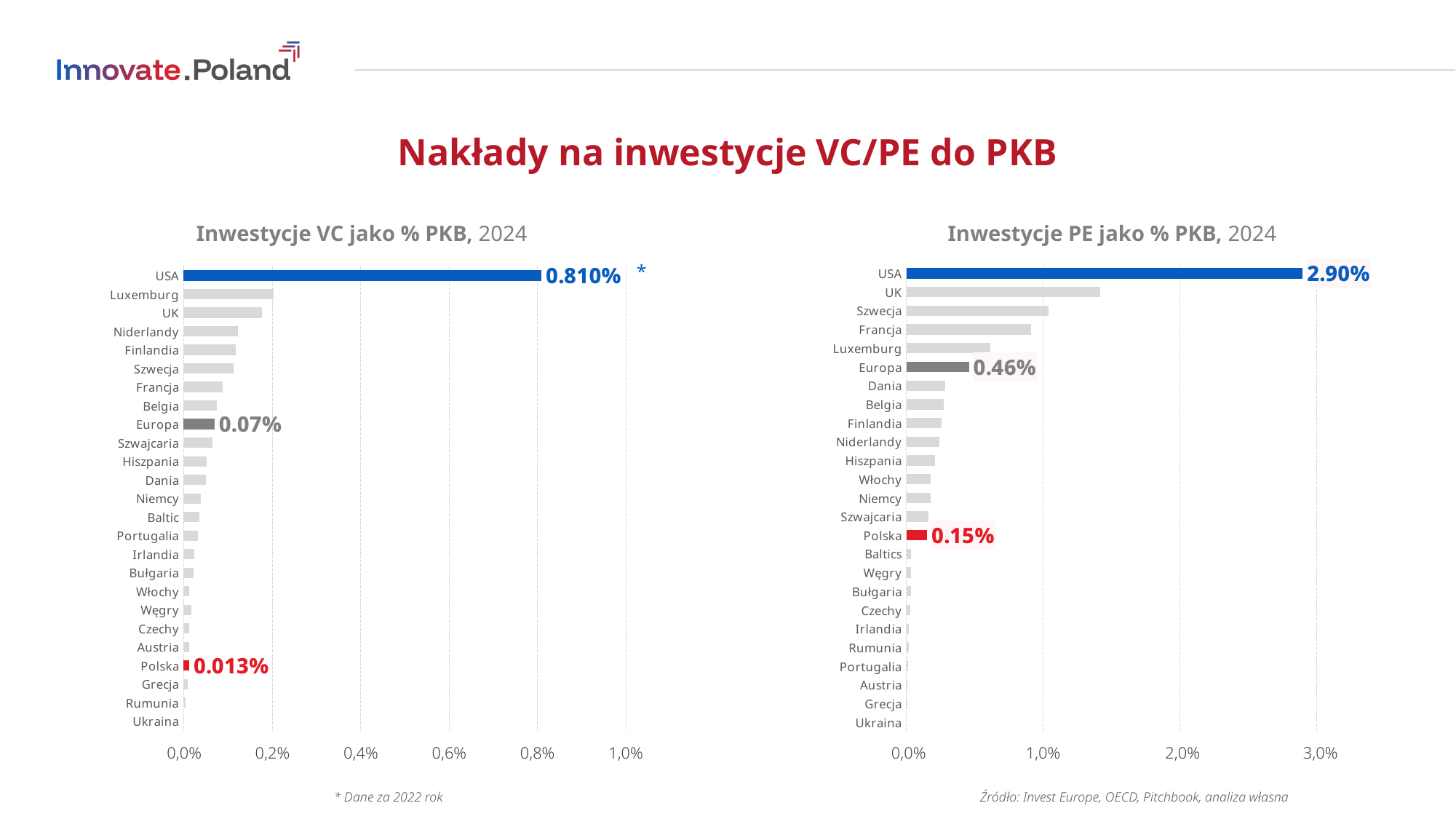
In the chart 'Inwestycje PE jako % PKB, 2024', which category has the highest value? USA In the chart 'Inwestycje VC jako % PKB, 2024', is the value for UK greater or less than 0,2%? less In the chart 'Inwestycje PE jako % PKB, 2024', what is the value for Polska? 0.15% In the chart 'Inwestycje VC jako % PKB, 2024', which category has the lowest value? Ukraina In the chart 'Inwestycje VC jako % PKB, 2024', what is the value for USA? 0.810% In the chart 'Inwestycje VC jako % PKB, 2024', what is the value for Polska? 0.013% In the chart 'Inwestycje PE jako % PKB, 2024', what is the difference between the values for USA and Europa? 2.44% What kind of chart is 'Inwestycje VC jako % PKB, 2024'? bar chart In the chart 'Inwestycje VC jako % PKB, 2024', which is larger, the value for Luxemburg or the value for Francja? Luxemburg In the chart 'Inwestycje PE jako % PKB, 2024', is the value for UK greater or less than 1,0%? greater In the chart 'Inwestycje PE jako % PKB, 2024', what is the value for Europa? 0.46% How many categories are shown in the chart 'Inwestycje PE jako % PKB, 2024'? 25